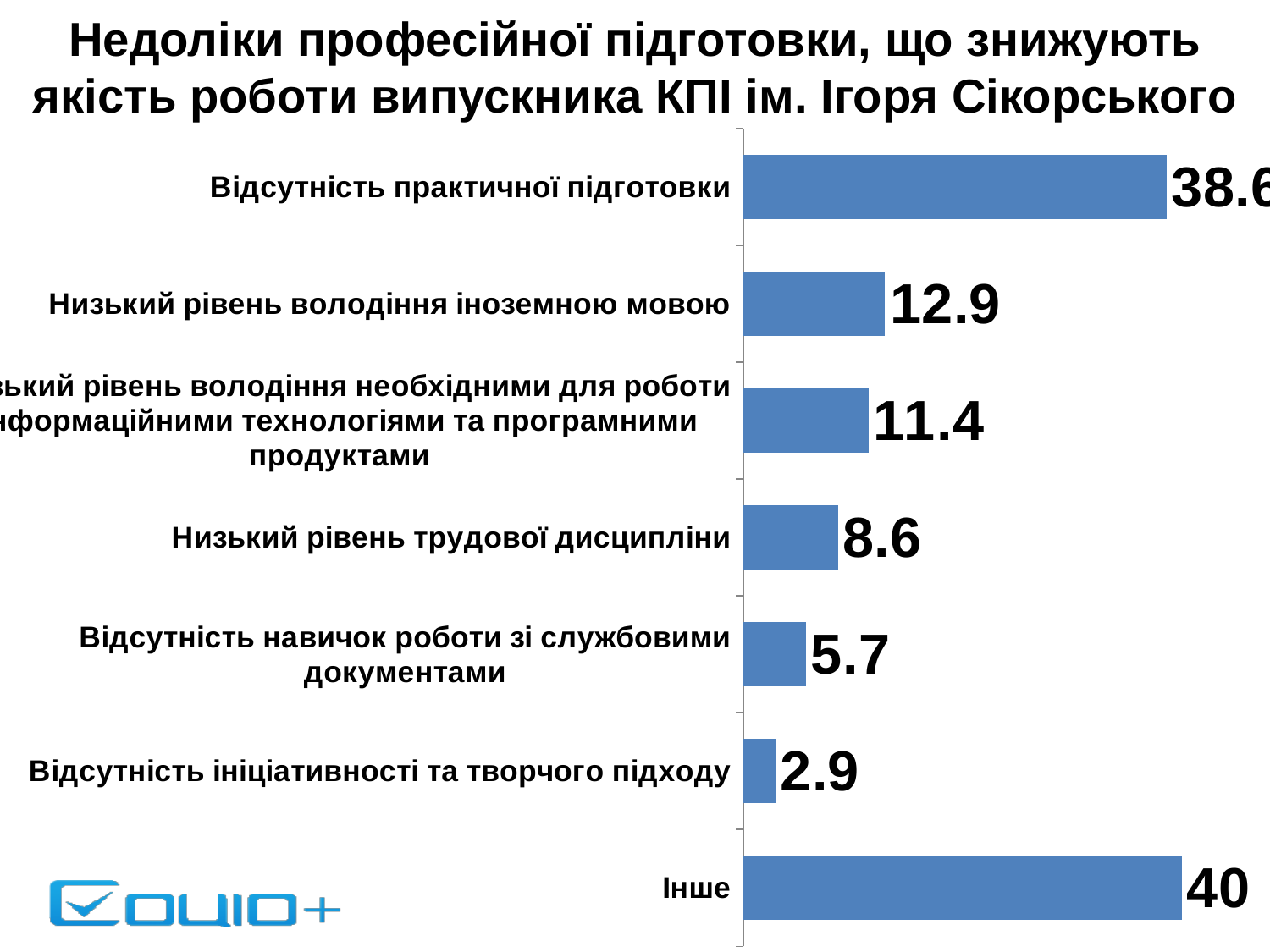
What is the value for "Інше"? 40 What is the value for "Низький рівень володіння іноземною мовою"? 12.9 What colour are the bars in the chart? blue What type of chart is shown on the slide? bar chart Which is larger: the value for "Низький рівень трудової дисципліни" or for "Відсутність навичок роботи зі службовими документами"? Низький рівень трудової дисципліни What is the value for "Низький рівень трудової дисципліни"? 8.6 How many categories are shown in the chart? 7 What is the value for "Відсутність ініціативності та творчого підходу"? 2.9 Which category has the lowest value? Відсутність ініціативності та творчого підходу What is the difference between the values for "Низький рівень володіння іноземною мовою" and "Низький рівень трудової дисципліни"? 4.3 What is the value for "Відсутність навичок роботи зі службовими документами"? 5.7 Which category has the highest value? Інше